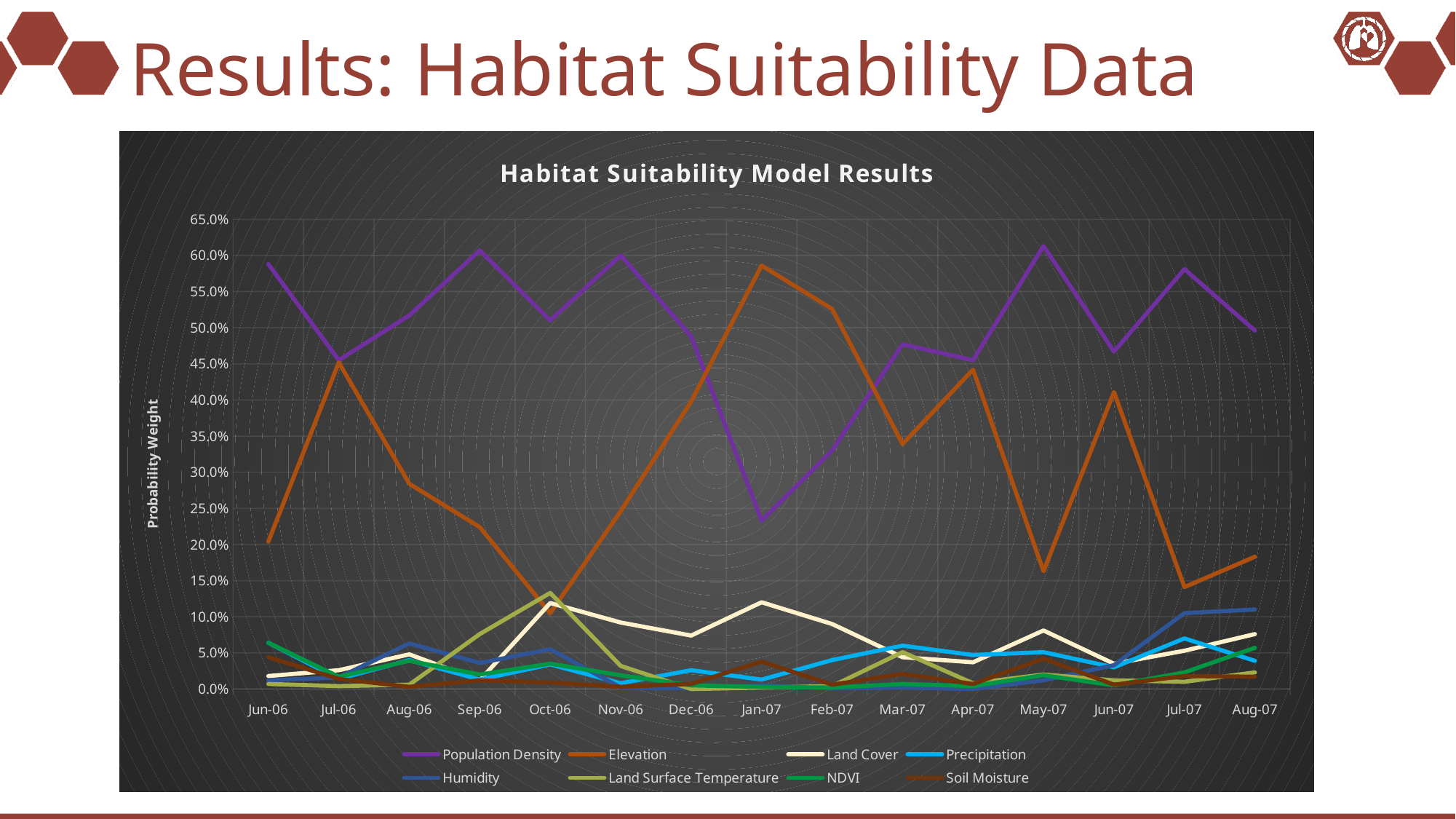
At Jan-07, which series has the larger value, Population Density or Elevation? Elevation How many months are shown along the x axis? 15 Which series has the highest value at Jun-06? Population Density At May-07, which series has the larger value, Population Density or Elevation? Population Density What kind of chart is shown on the slide? line chart Is the value for Elevation at Jul-07 greater or less than 20.0%? less Is the value for Population Density at Jun-06 greater or less than 55.0%? greater What is the title of the chart? Habitat Suitability Model Results Is the value for Elevation at Jan-07 greater or less than 55.0%? greater What is the label on the vertical axis? Probability Weight How many series does the legend list? 8